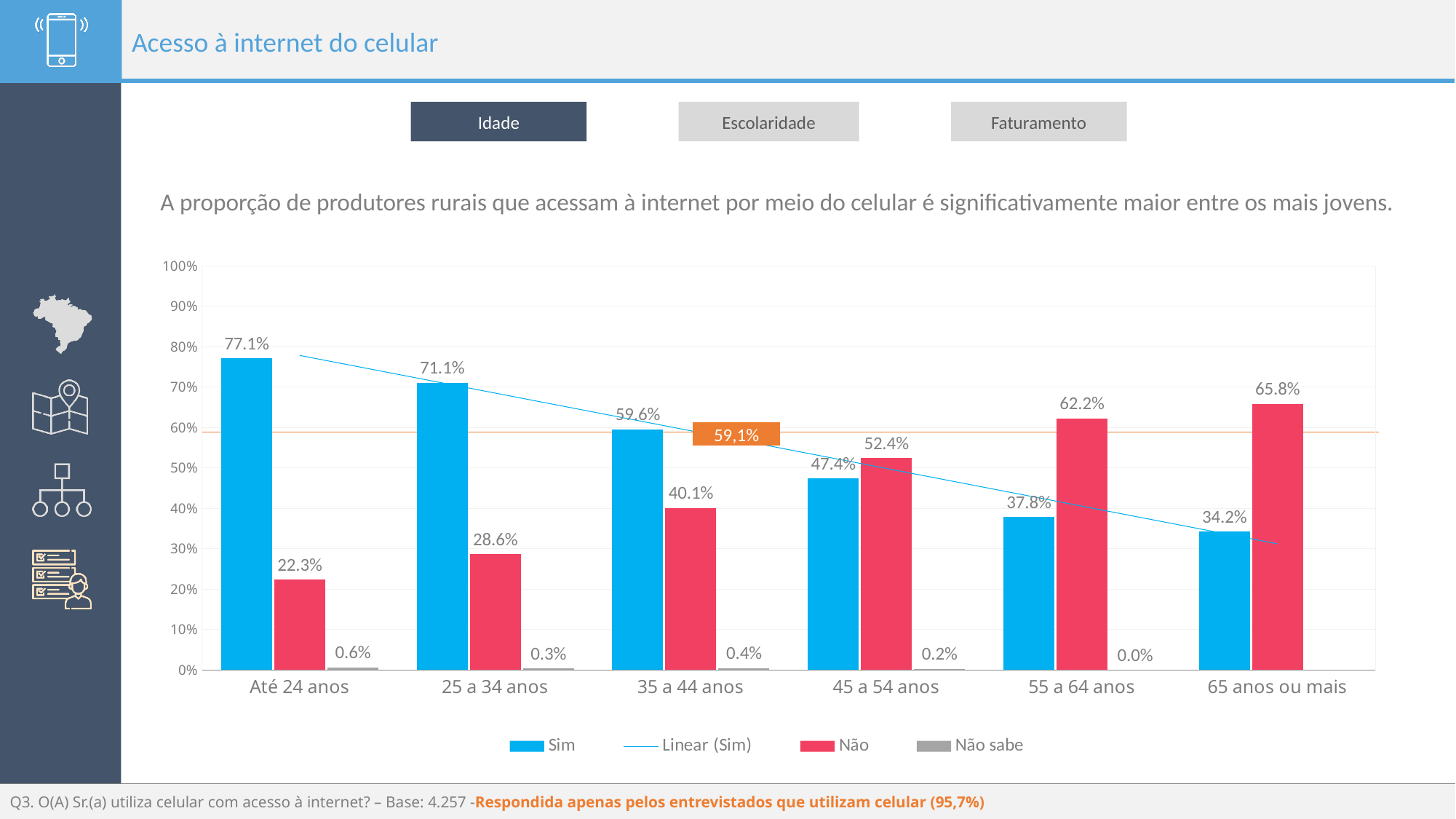
What is the difference between the 'Sim' values for 'Até 24 anos' and '25 a 34 anos'? 6.0% What is the value of 'Não sabe' for the '35 a 44 anos' age group? 0.4% How many entries does the legend list? 4 How many age groups are shown on the x axis? 6 Which age group has the lowest 'Não' value? Até 24 anos What is the value of 'Sim' for the 'Até 24 anos' age group? 77.1% Do the 'Sim' values rise or fall as age increases along the x axis? Fall What value is shown in the orange label on the horizontal reference line? 59,1% Which is larger for the '45 a 54 anos' group: 'Sim' or 'Não'? Não What kind of chart is shown on the slide? Bar chart What is the value of 'Não' for the '65 anos ou mais' age group? 65.8% Which age group has the highest 'Sim' value? Até 24 anos